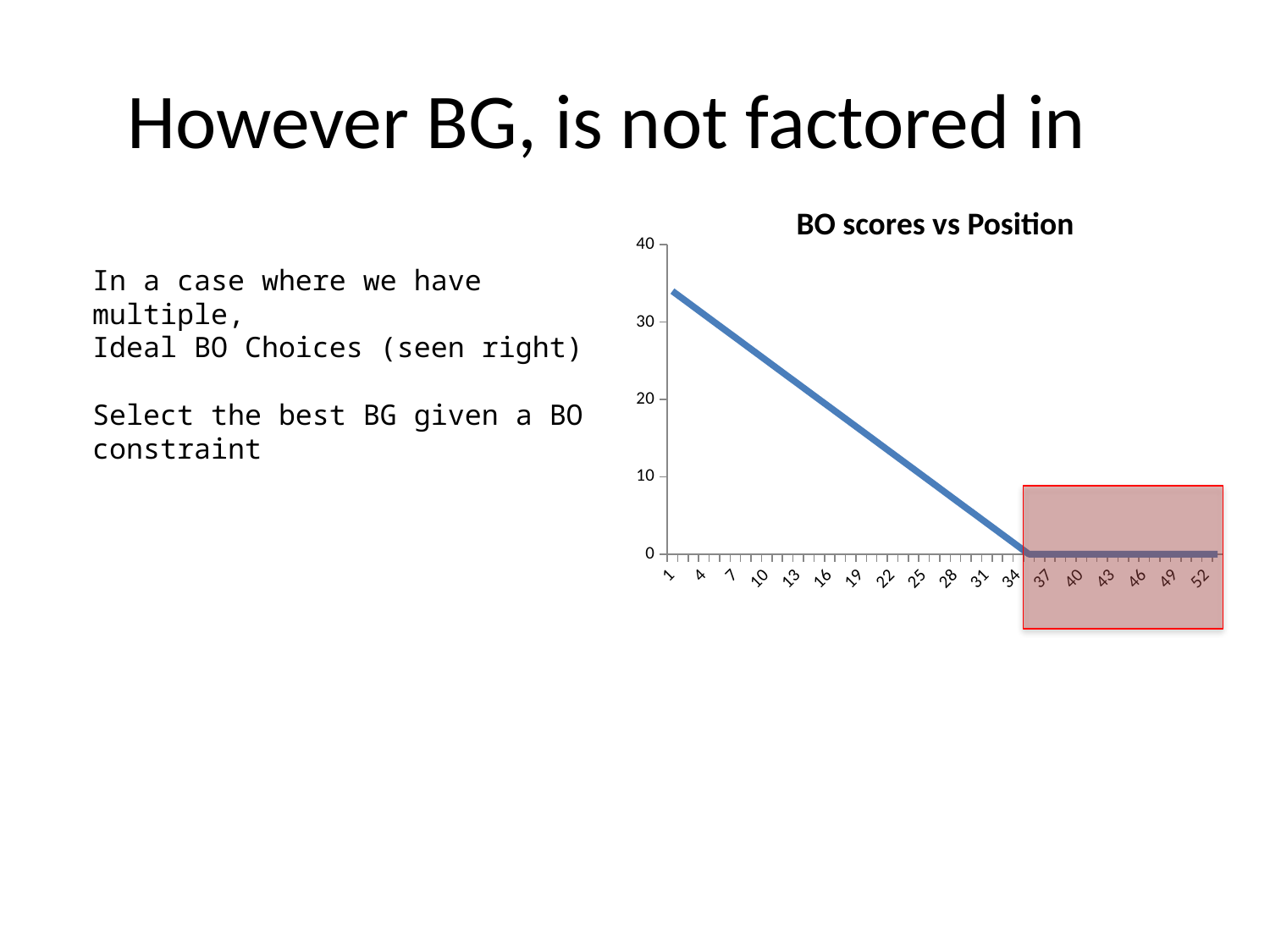
What is the last position label shown on the x axis? 52 What kind of chart is shown on the slide? line chart Which position has the larger BO score, 4 or 31? 4 Is the BO score at position 19 greater or less than 10? greater What is the highest value shown on the y axis? 40 Do the BO scores rise or fall as position increases from 1 to 34? fall Is the BO score at position 1 greater or less than 30? greater Is the BO score at position 10 greater or less than 20? greater At which position is the BO score highest? 1 What is the title of the chart? BO scores vs Position What is the BO score at position 52? 0